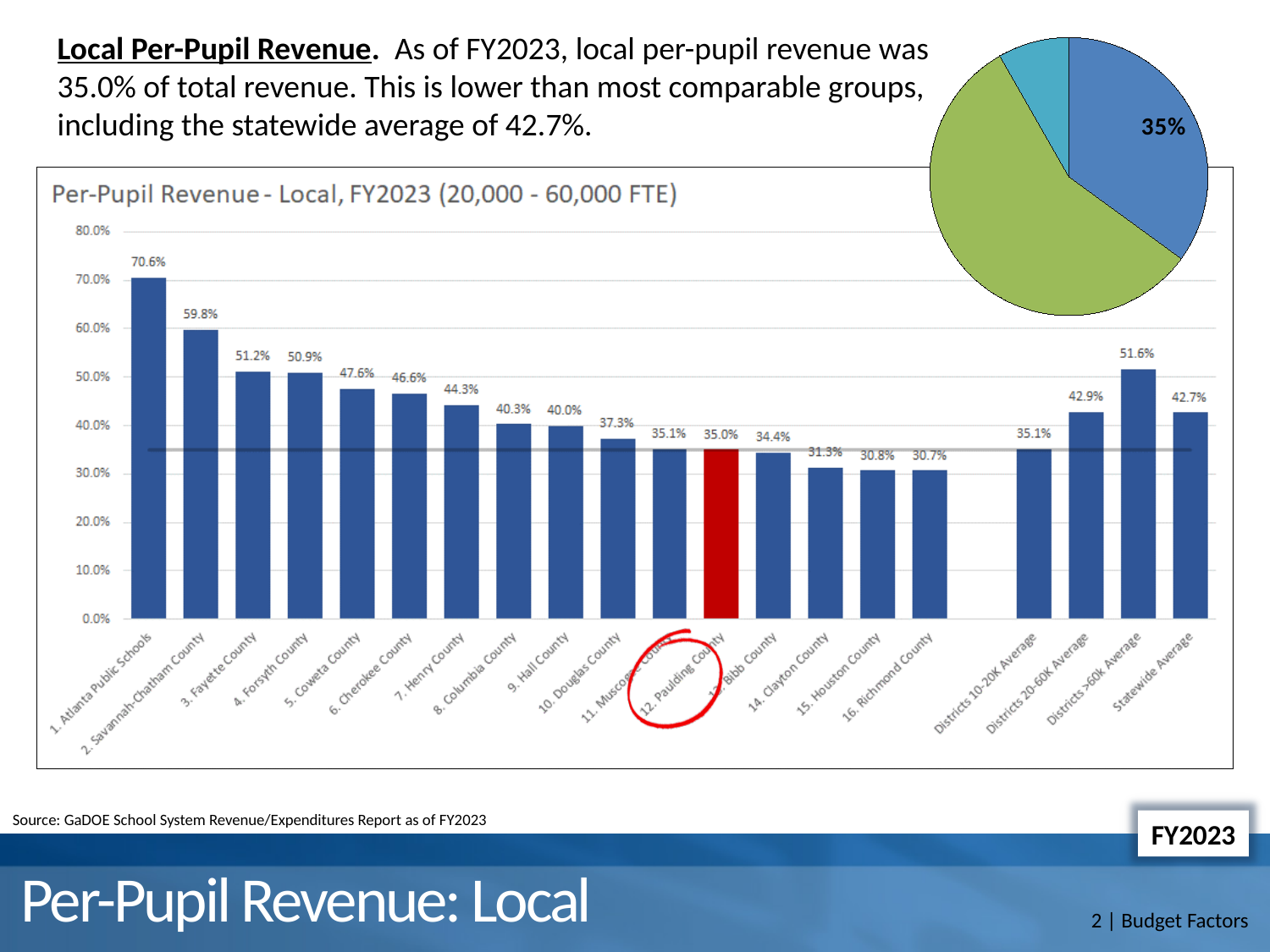
In the pie chart at the top right, what share is shown for the blue slice? 35% In the bar chart, what is the value for Atlanta Public Schools? 70.6% What kind of chart is the chart titled "Per-Pupil Revenue - Local, FY2023 (20,000 - 60,000 FTE)"? bar chart In the bar chart, what is the value for the Statewide Average? 42.7% In the bar chart, which category has the lowest value? Richmond County In the bar chart, what is the difference between the Statewide Average and Paulding County? 7.7% In the bar chart, which is larger, Forsyth County or Coweta County? Forsyth County How many bars are plotted in the bar chart? 20 In the bar chart, is the value for Savannah-Chatham County greater or less than 50.0%? greater In the bar chart, which category has the highest value? Atlanta Public Schools In the bar chart, what is the value for Districts >60K Average? 51.6% In the bar chart, what is the value for Paulding County? 35.0%